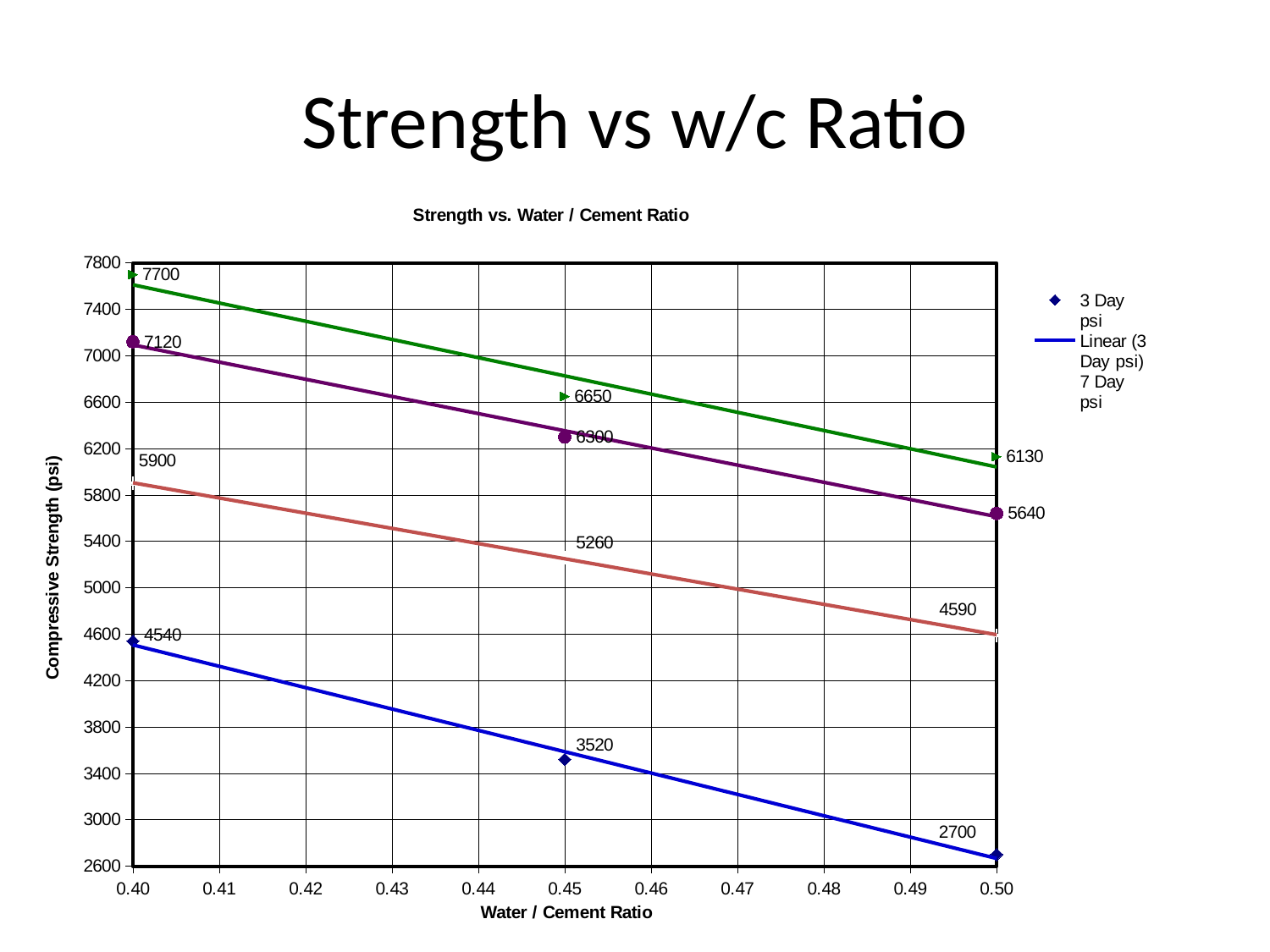
What is the lowest data label shown on the chart? 2700 Which is larger: the 7 Day psi value at 0.45 or the 3 Day psi value at 0.40? 7 Day psi at 0.45 What is the 7 Day psi value at a water/cement ratio of 0.40? 5900 Does the 3 Day psi strength rise or fall as the water/cement ratio increases? Falls What is the difference between the 7 Day psi values at water/cement ratios of 0.40 and 0.45? 640 What is the 3 Day psi value at a water/cement ratio of 0.40? 4540 What is the title of the chart's vertical axis? Compressive Strength (psi) By how much does the 3 Day psi value drop between a water/cement ratio of 0.40 and 0.50? 1840 What is the 7 Day psi value at a water/cement ratio of 0.50? 4590 What is the 3 Day psi value at a water/cement ratio of 0.45? 3520 What is the 3 Day psi value at a water/cement ratio of 0.50? 2700 What is the highest data label shown on the chart? 7700